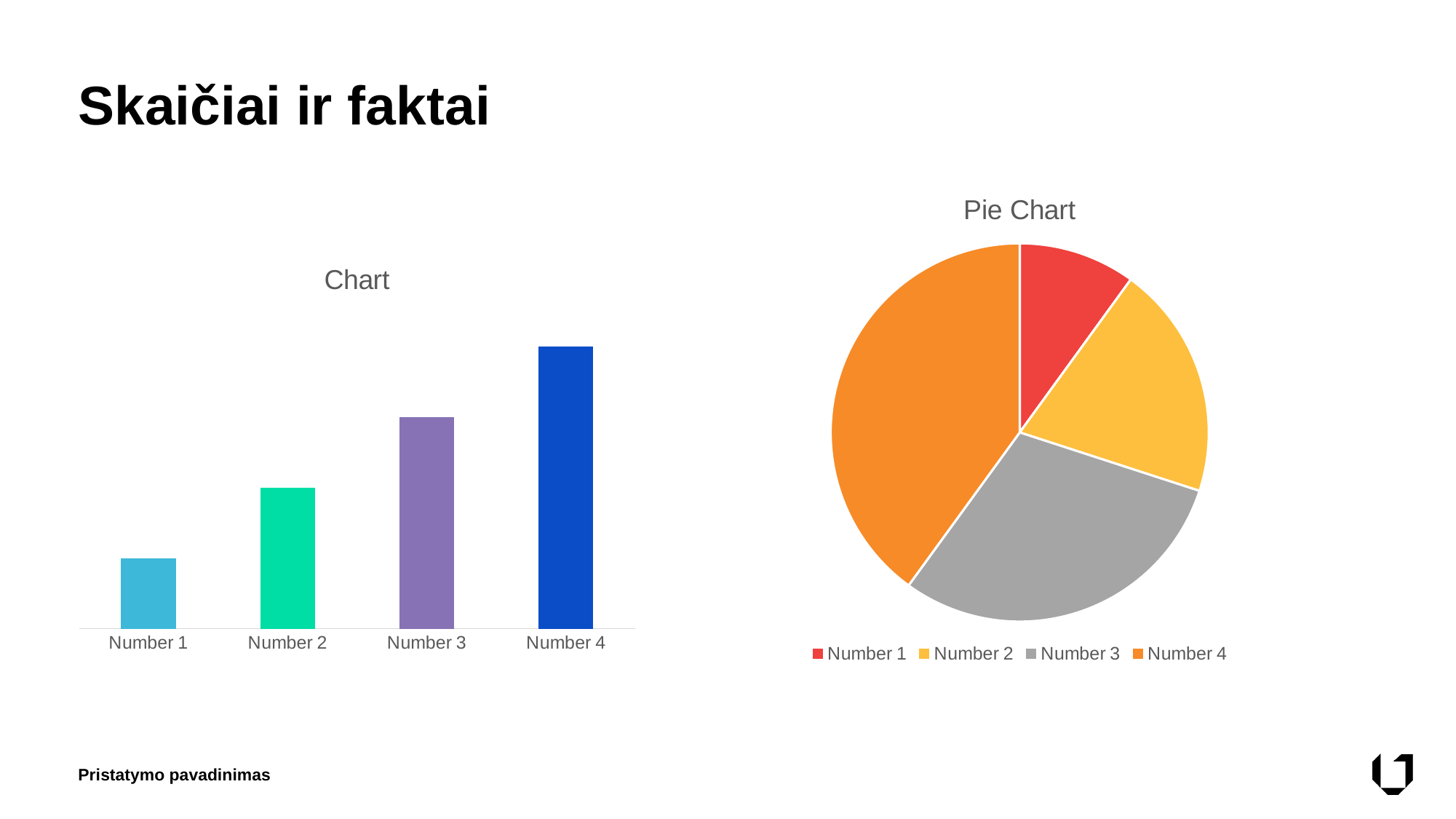
In the chart titled "Chart", do the values rise or fall from Number 1 to Number 4? rise In the chart titled "Chart", how many categories are shown on the x axis? 4 In the chart titled "Pie Chart", how many slices does the pie have? 4 In the chart titled "Chart", which is larger, the value for Number 2 or the value for Number 3? Number 3 What kind of chart is the chart titled "Chart" on the left of the slide? bar chart In the chart titled "Pie Chart", which slice is larger, Number 2 or Number 3? Number 3 What kind of chart is the chart titled "Pie Chart" on the right of the slide? pie chart In the chart titled "Pie Chart", which slice is the smallest? Number 1 In the chart titled "Chart", which category has the lowest value? Number 1 In the chart titled "Pie Chart", how many entries does the legend list? 4 In the chart titled "Pie Chart", which slice is the largest? Number 4 In the chart titled "Chart", which category has the highest value? Number 4